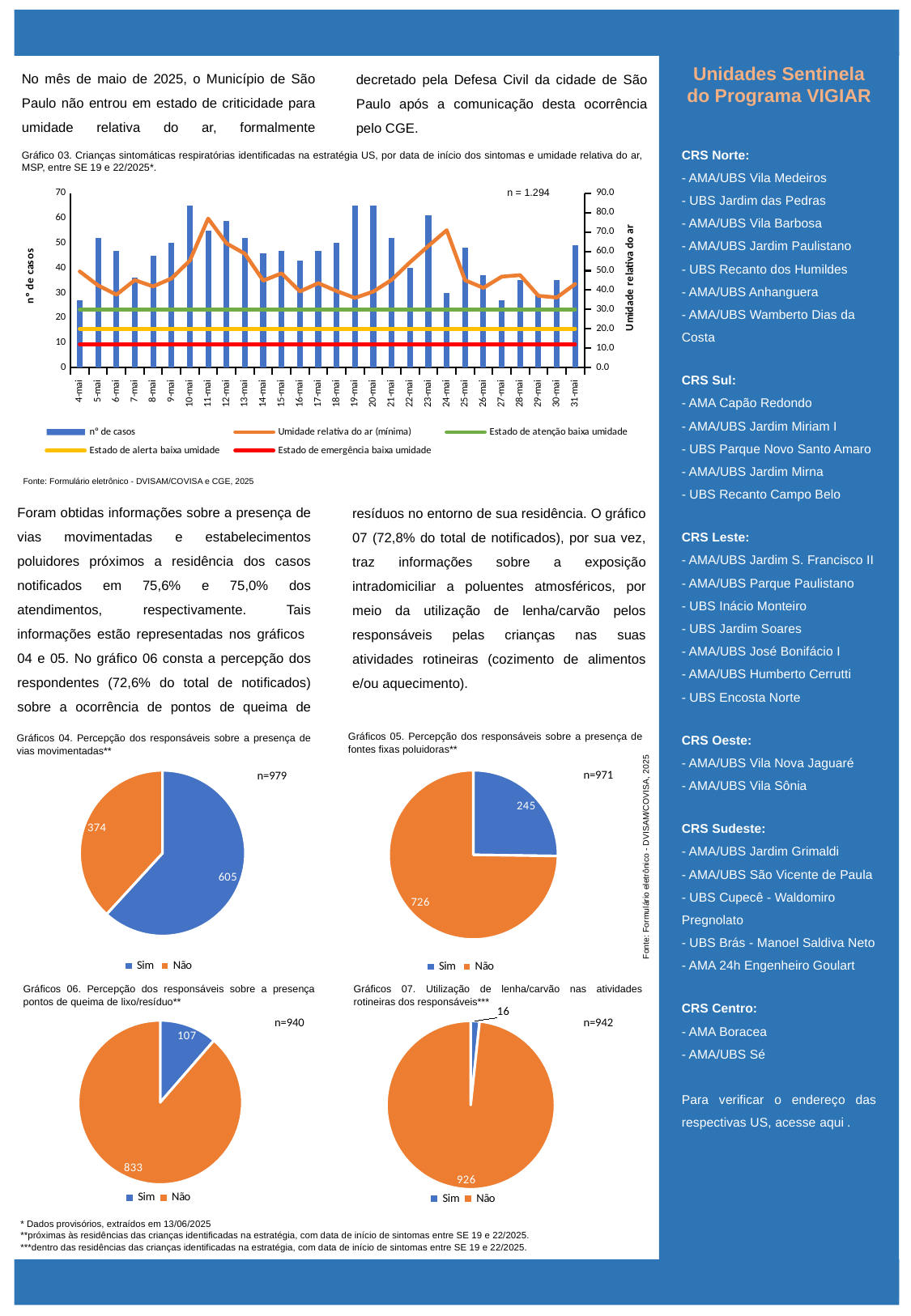
In Gráfico 03, is the number of cases (n° de casos) for 10-mai greater or less than 60? greater What is the n value shown on Gráfico 06? n=940 In Gráfico 04 (presença de vias movimentadas), what is the value for 'Sim'? 605 In Gráfico 05 (presença de fontes fixas poluidoras), what is the value for 'Não'? 726 How many series does the legend of Gráfico 03 list? 5 In Gráfico 07 (utilização de lenha/carvão), what is the value for 'Sim'? 16 In Gráfico 04, which category has the highest value? Sim In Gráfico 05, which slice is larger, 'Sim' or 'Não'? Não How many dates are shown on the x axis of Gráfico 03? 28 What kind of chart is Gráfico 04? Pie chart In Gráfico 03, is the number of cases (n° de casos) for 16-mai greater or less than 50? less In Gráfico 06 (pontos de queima de lixo/resíduo), what is the difference between the 'Não' and 'Sim' values? 726